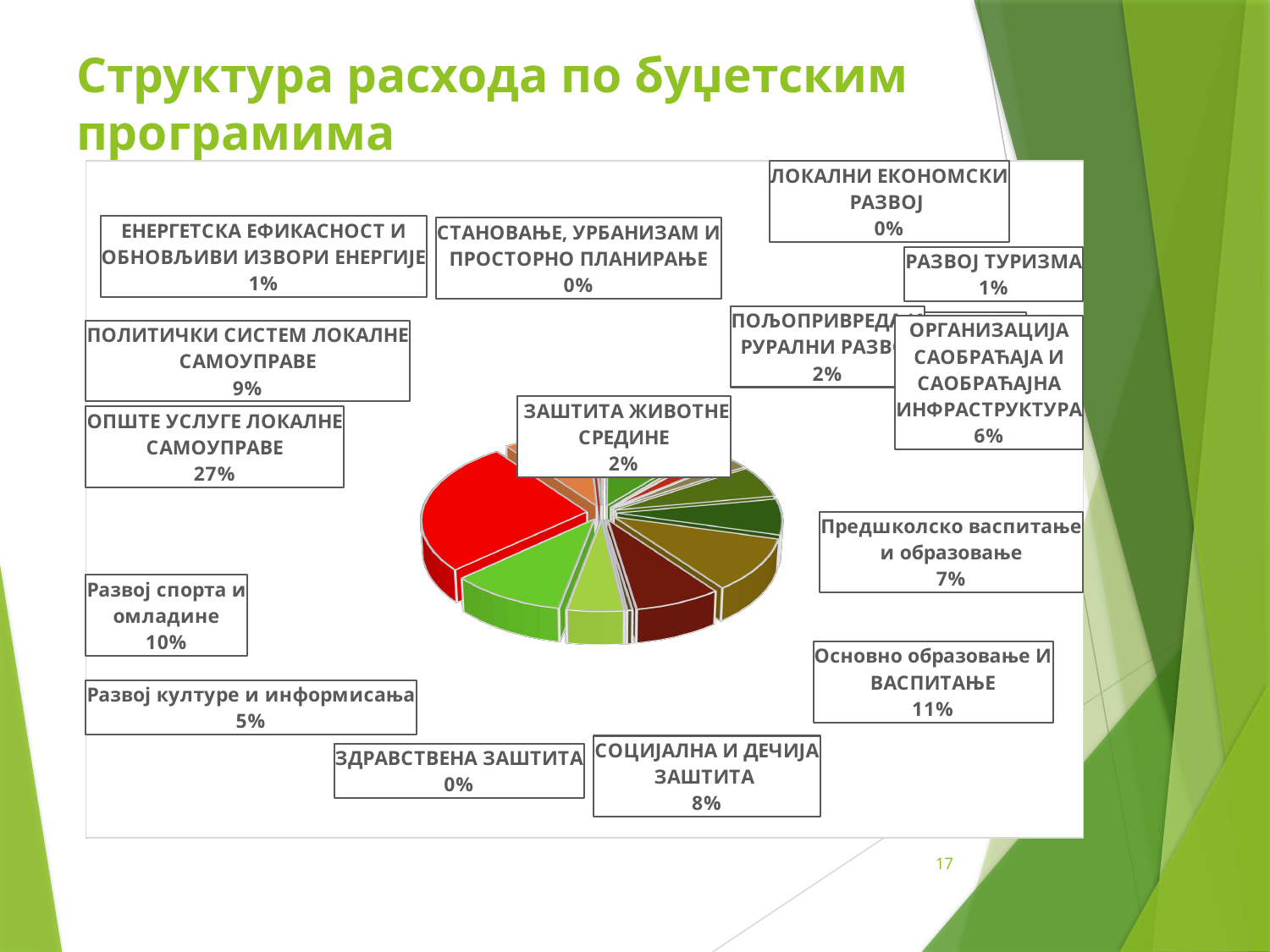
What type of chart is shown on the slide? pie chart What percentage is shown for ЗДРАВСТВЕНА ЗАШТИТА? 0% What is the combined share of Развој спорта и омладине and Развој културе и информисања? 15% What share is labelled for СОЦИЈАЛНА И ДЕЧИЈА ЗАШТИТА? 8% What is the title of the chart on the slide? Структура расхода по буџетским програмима What percentage is shown for Основно образовање И ВАСПИТАЊЕ? 11% Which budget programme has the largest share of expenditure? ОПШТЕ УСЛУГЕ ЛОКАЛНЕ САМОУПРАВЕ What share of expenditure goes to ОПШТЕ УСЛУГЕ ЛОКАЛНЕ САМОУПРАВЕ? 27% Which has a larger share: Предшколско васпитање и образовање or Развој културе и информисања? Предшколско васпитање и образовање What is the difference in percentage points between ОПШТЕ УСЛУГЕ ЛОКАЛНЕ САМОУПРАВЕ and Основно образовање И ВАСПИТАЊЕ? 16 percentage points What percentage is shown for ОРГАНИЗАЦИЈА САОБРАЋАЈА И САОБРАЋАЈНА ИНФРАСТРУКТУРА? 6% What percentage is shown for Развој спорта и омладине? 10%